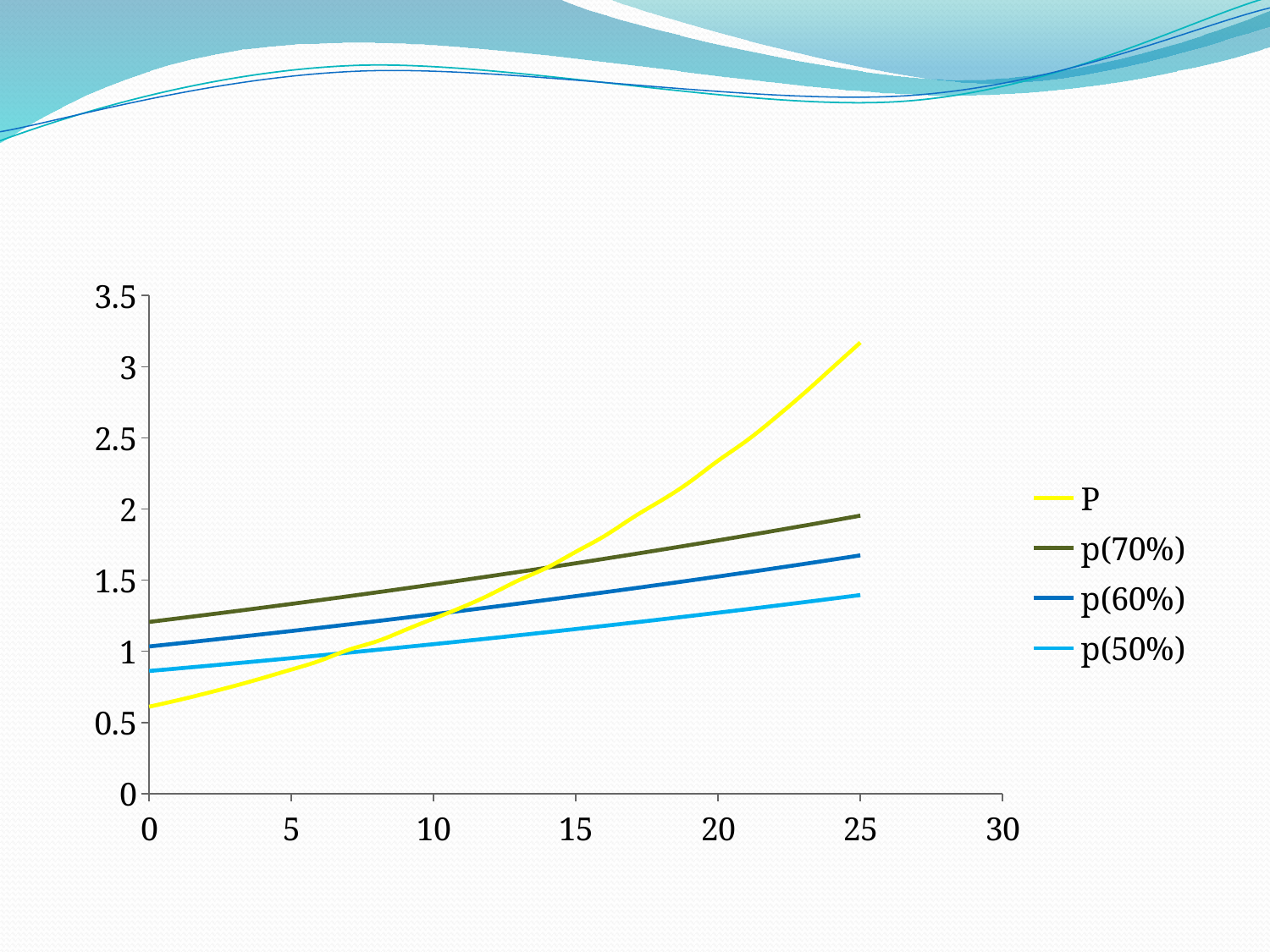
Do the values of the P series rise or fall as x increases? rise Is the value of the p(70%) series at x = 25 greater or less than 2? less Which series has the highest value at x = 25? P What colour is the line for the P series? yellow Which series has the lowest value at x = 25? p(50%) What kind of chart is shown on the slide? line chart At x = 25, which is larger: the value of P or the value of p(60%)? P Which series has the lowest value at x = 0? P How many series does the legend list? 4 At x = 0, which is larger: the value of p(70%) or the value of p(50%)? p(70%) Is the value of the P series at x = 25 greater or less than 3? greater Is the value of the P series at x = 0 greater or less than 1? less